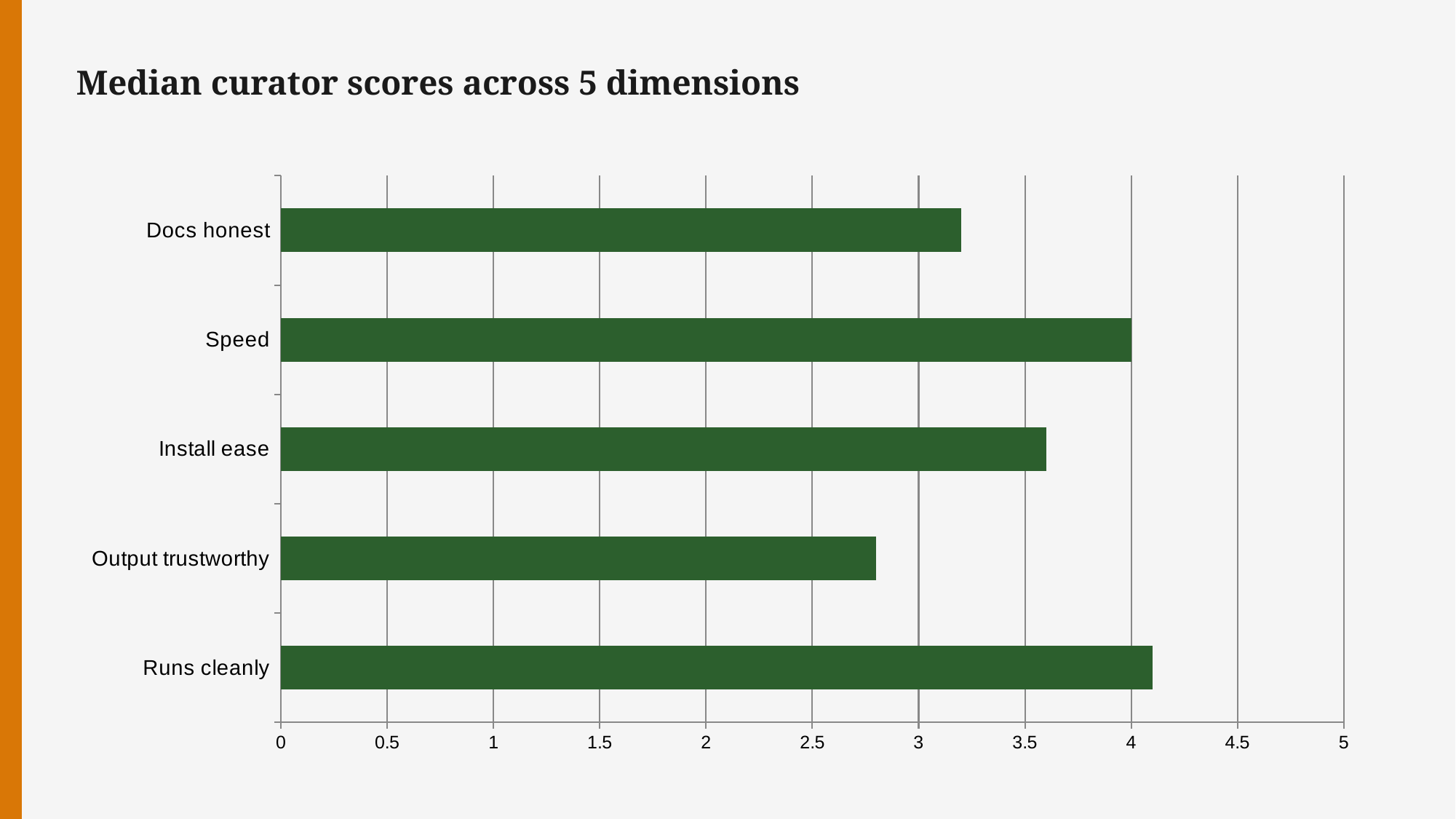
How many dimensions (categories) are plotted in the chart? 5 What is the maximum value shown on the horizontal axis? 5 Is the value for Install ease greater or less than 3.5? greater Which has the larger median score, Install ease or Docs honest? Install ease What kind of chart is shown on the slide? bar chart What is the title of the chart? Median curator scores across 5 dimensions Is the value for Output trustworthy greater or less than 3? less Is the value for Docs honest greater or less than 3? greater What is the median curator score for Speed? 4 Which dimension has the lowest median curator score? Output trustworthy Which has the larger median score, Output trustworthy or Speed? Speed